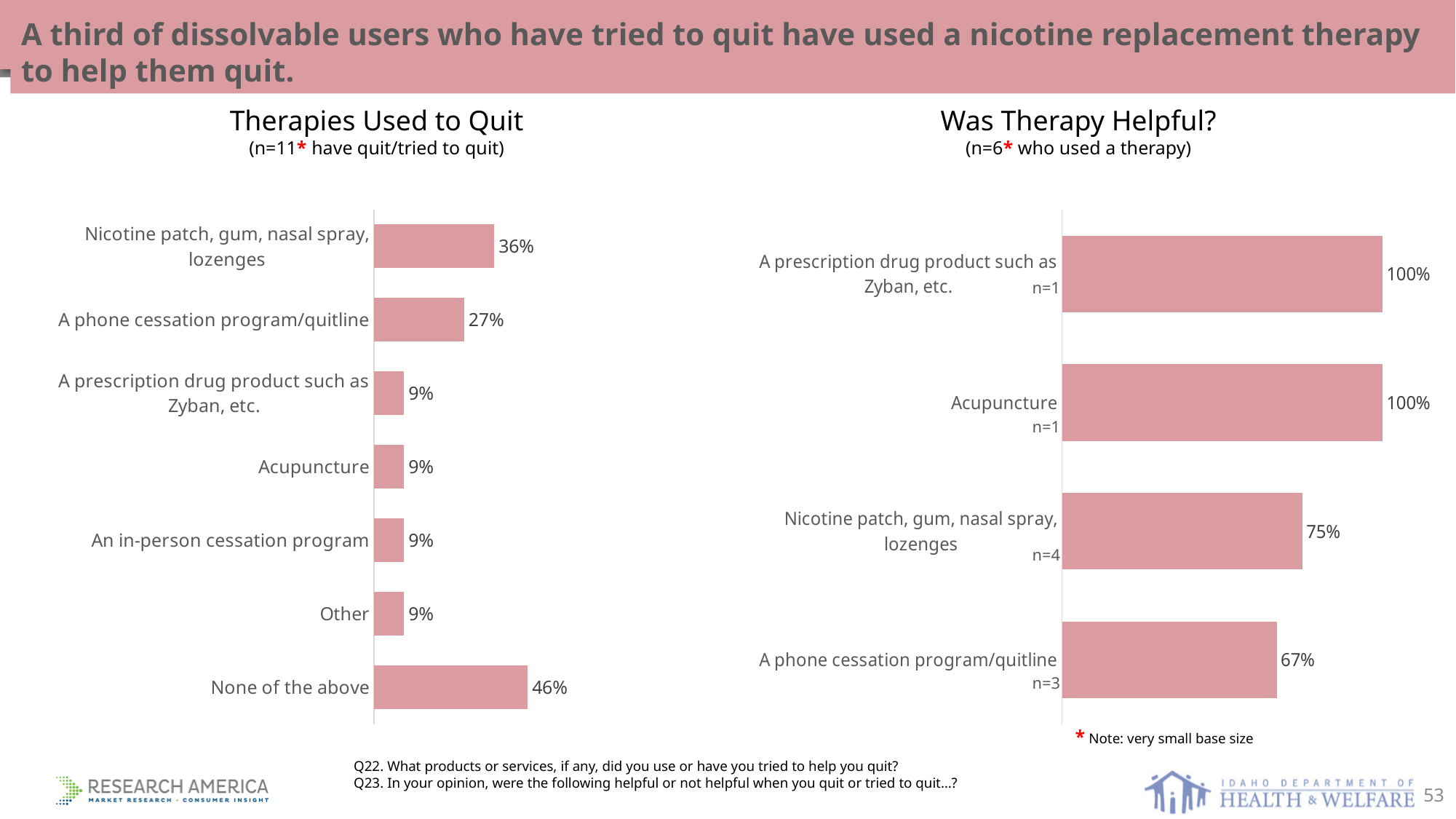
What type of chart is the 'Was Therapy Helpful?' chart? Bar chart In the 'Therapies Used to Quit' chart, which is larger: 'A phone cessation program/quitline' or 'Acupuncture'? A phone cessation program/quitline In the 'Therapies Used to Quit' chart, what percentage used a nicotine patch, gum, nasal spray, or lozenges? 36% In the 'Therapies Used to Quit' chart, how many categories are shown? 7 In the 'Was Therapy Helpful?' chart, what percentage found a phone cessation program/quitline helpful? 67% In the 'Therapies Used to Quit' chart, which category has the highest value? None of the above What is the base size (n) shown in the subtitle of the 'Was Therapy Helpful?' chart? n=6 In the 'Was Therapy Helpful?' chart, what percentage found nicotine patch, gum, nasal spray, or lozenges helpful? 75% In the 'Therapies Used to Quit' chart, what percentage used a phone cessation program/quitline? 27% In the 'Was Therapy Helpful?' chart, which category has the lowest value? A phone cessation program/quitline In the 'Therapies Used to Quit' chart, what is the difference between 'None of the above' and 'Nicotine patch, gum, nasal spray, lozenges'? 10 percentage points In the 'Was Therapy Helpful?' chart, what is the difference between 'Acupuncture' and 'A phone cessation program/quitline'? 33 percentage points